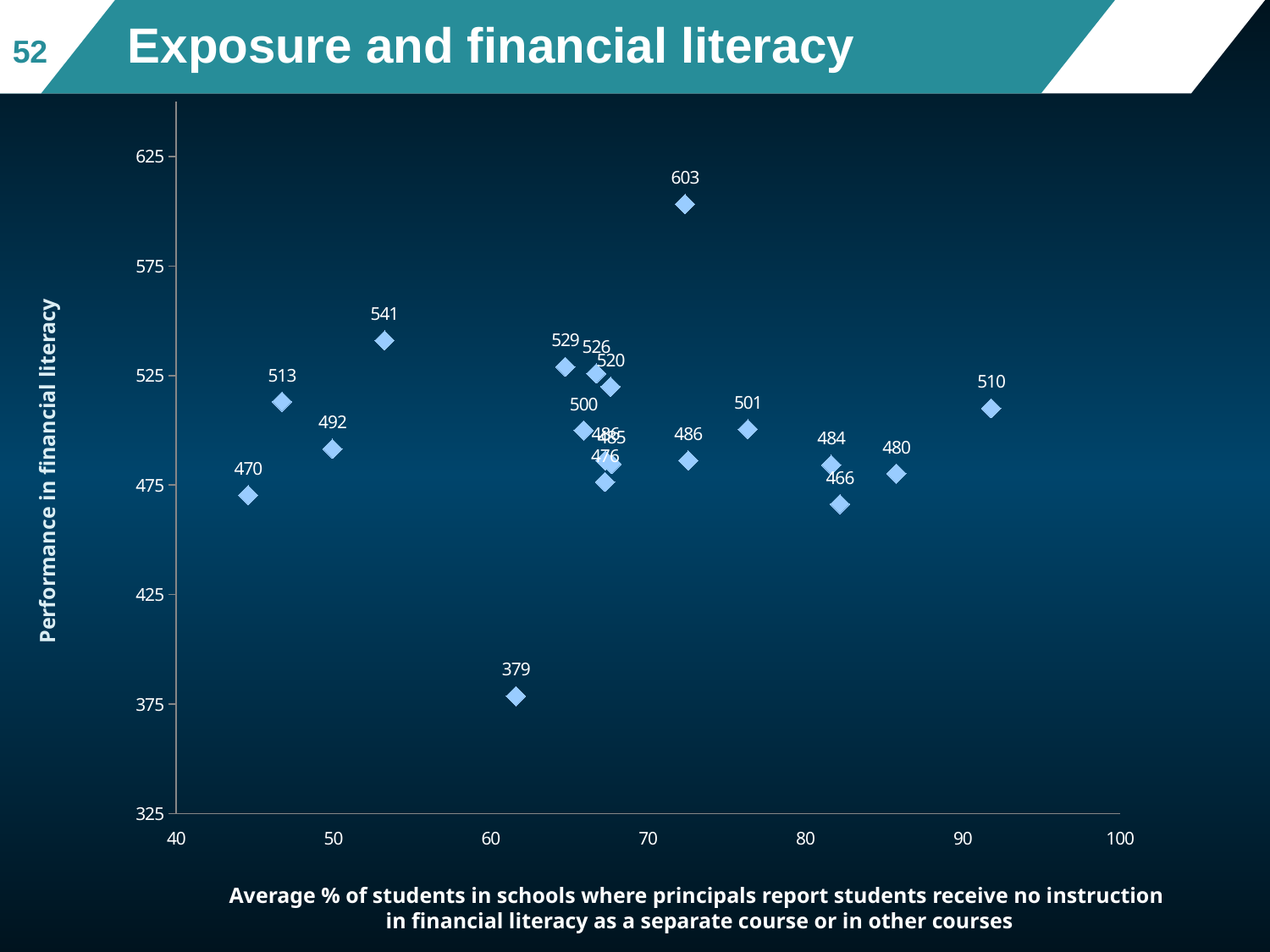
Is the x-axis value of the point labelled 603 greater or less than 70? greater What is the difference between the points labelled 541 and 513? 28 Is the x-axis value of the point labelled 470 greater or less than 50? less Is the x-axis value of the point labelled 510 greater or less than 80? greater What kind of chart is shown on the slide? scatter chart What is the title of the vertical axis? Performance in financial literacy What is the highest performance value labelled on the chart? 603 Which labelled value is larger, 541 or 529? 541 What is the lowest performance value labelled on the chart? 379 What is the title of the chart slide? Exposure and financial literacy What is the difference between the highest labelled value (603) and the lowest labelled value (379)? 224